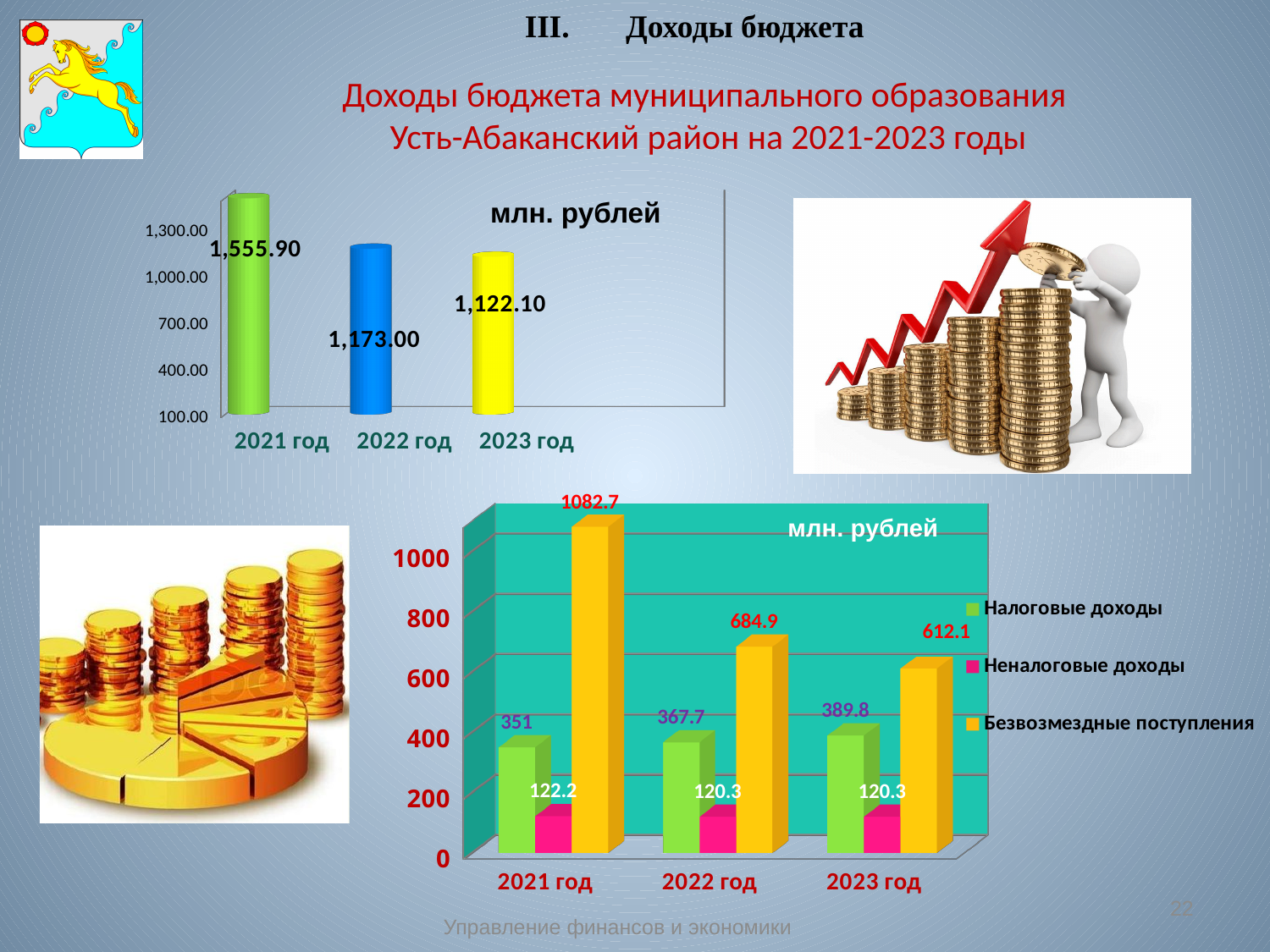
In the bottom chart, what is the value of Неналоговые доходы for 2022 год? 120.3 In the top-left chart, what is the difference between the values for 2021 год and 2022 год? 382.90 In the bottom chart, what is the difference between Налоговые доходы for 2023 год and 2021 год? 38.8 In the bottom chart, what is the value of Безвозмездные поступления for 2021 год? 1082.7 In the top-left chart, how many bars are plotted? 3 In the top-left chart, what is the value for 2021 год? 1,555.90 In the top-left chart, do the values rise or fall from 2021 год to 2023 год? fall In the bottom chart, how many series does the legend list? 3 In the bottom chart, what is the value of Налоговые доходы for 2023 год? 389.8 In the bottom chart, which is larger: Безвозмездные поступления for 2022 год or for 2023 год? 2022 год In the top-left chart, what is the value for 2023 год? 1,122.10 In the top-left chart, which year has the lowest value? 2023 год